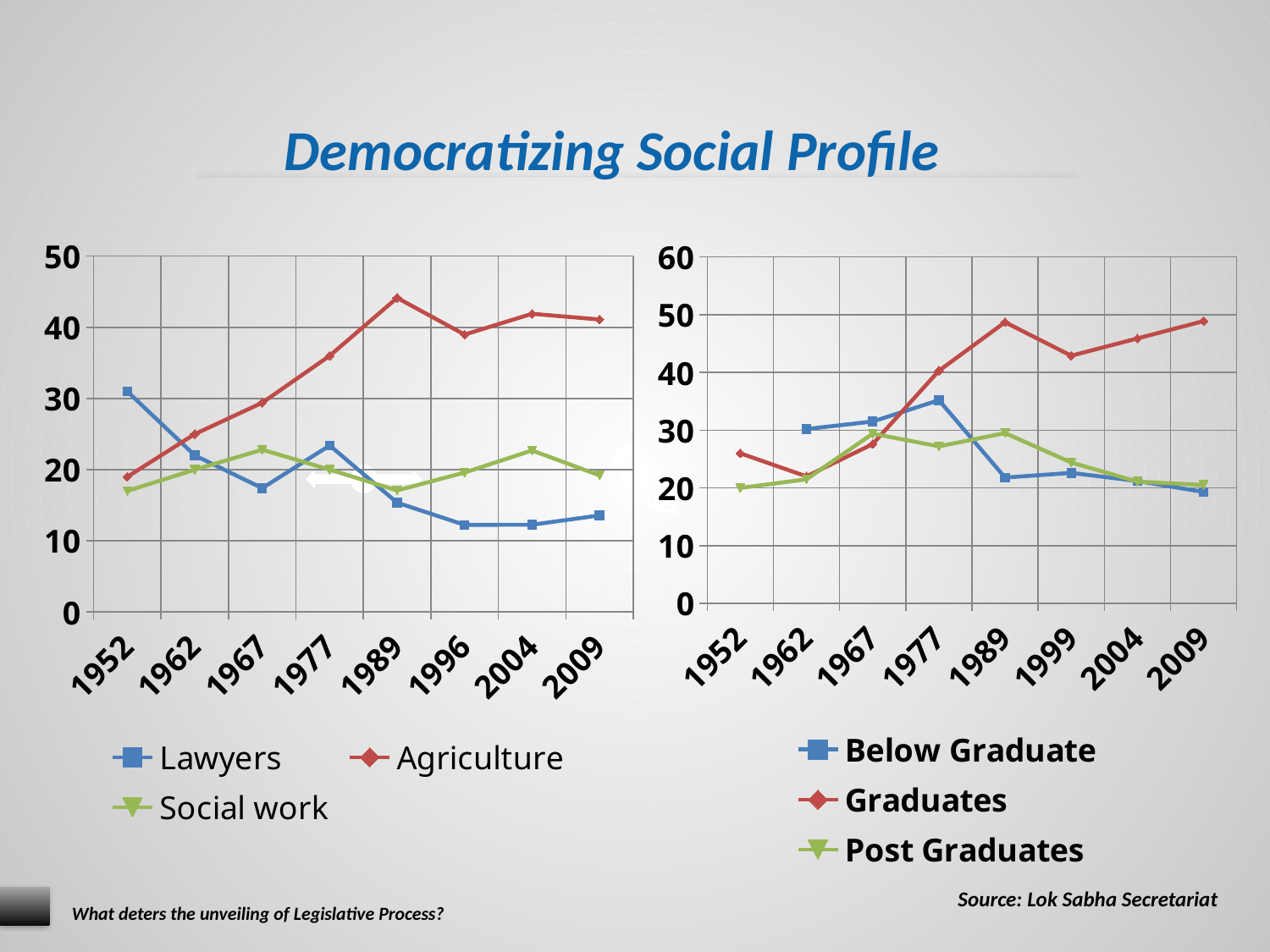
In the right chart, which is larger in 1952, Graduates or Post Graduates? Graduates How many years are shown on the x axis of the left chart? 8 In the right chart, is the Graduates value for 1999 greater or less than 40? greater In the left chart, in which year is the Lawyers value highest? 1952 How many series does the legend of the right chart list? 3 In the left chart, is the Lawyers value for 1996 greater or less than 20? less In the left chart, in which year does the Agriculture line reach its highest value? 1989 What kind of chart is the left chart on the slide? line chart In the left chart, is the Agriculture value for 1989 greater or less than 40? greater In the right chart, in which year does the Below Graduate line reach its highest value? 1977 In the left chart, which is larger in 2009, Agriculture or Lawyers? Agriculture In the left chart, does the Lawyers line overall rise or fall from 1952 to 2009? fall